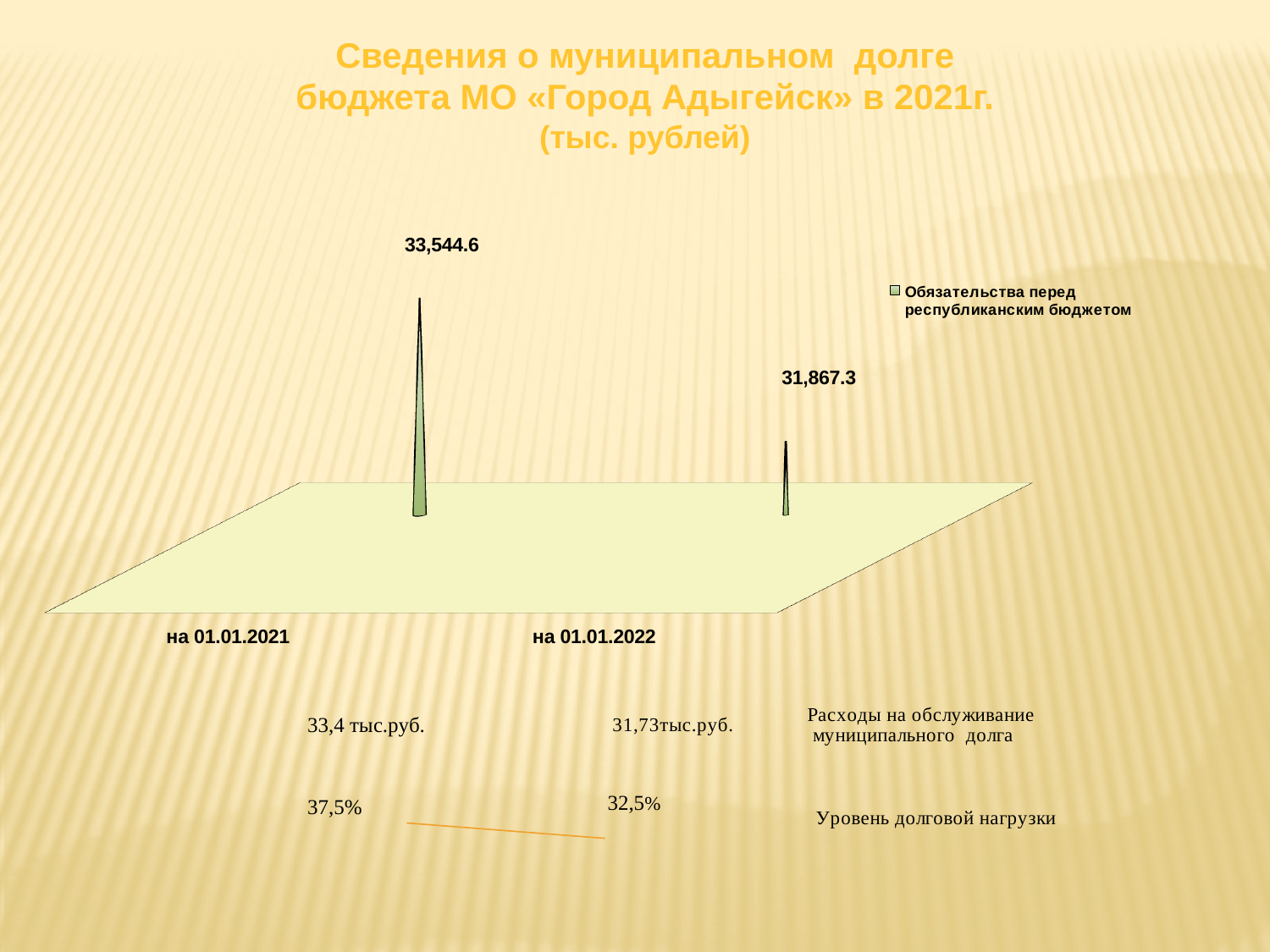
Which category has the highest value? на 01.01.2021 Which category has the lowest value? на 01.01.2022 What kind of chart is shown on the slide? bar chart How many series does the legend list? 1 How many categories are shown on the chart? 2 What unit is stated in the chart title? тыс. рублей What is the value for "на 01.01.2022"? 31,867.3 What series name does the legend show? Обязательства перед республиканским бюджетом What is the difference between the values for "на 01.01.2021" and "на 01.01.2022"? 1,677.3 Which is larger, the value for "на 01.01.2021" or for "на 01.01.2022"? на 01.01.2021 Do the values rise or fall from "на 01.01.2021" to "на 01.01.2022"? fall What is the value for "на 01.01.2021"? 33,544.6